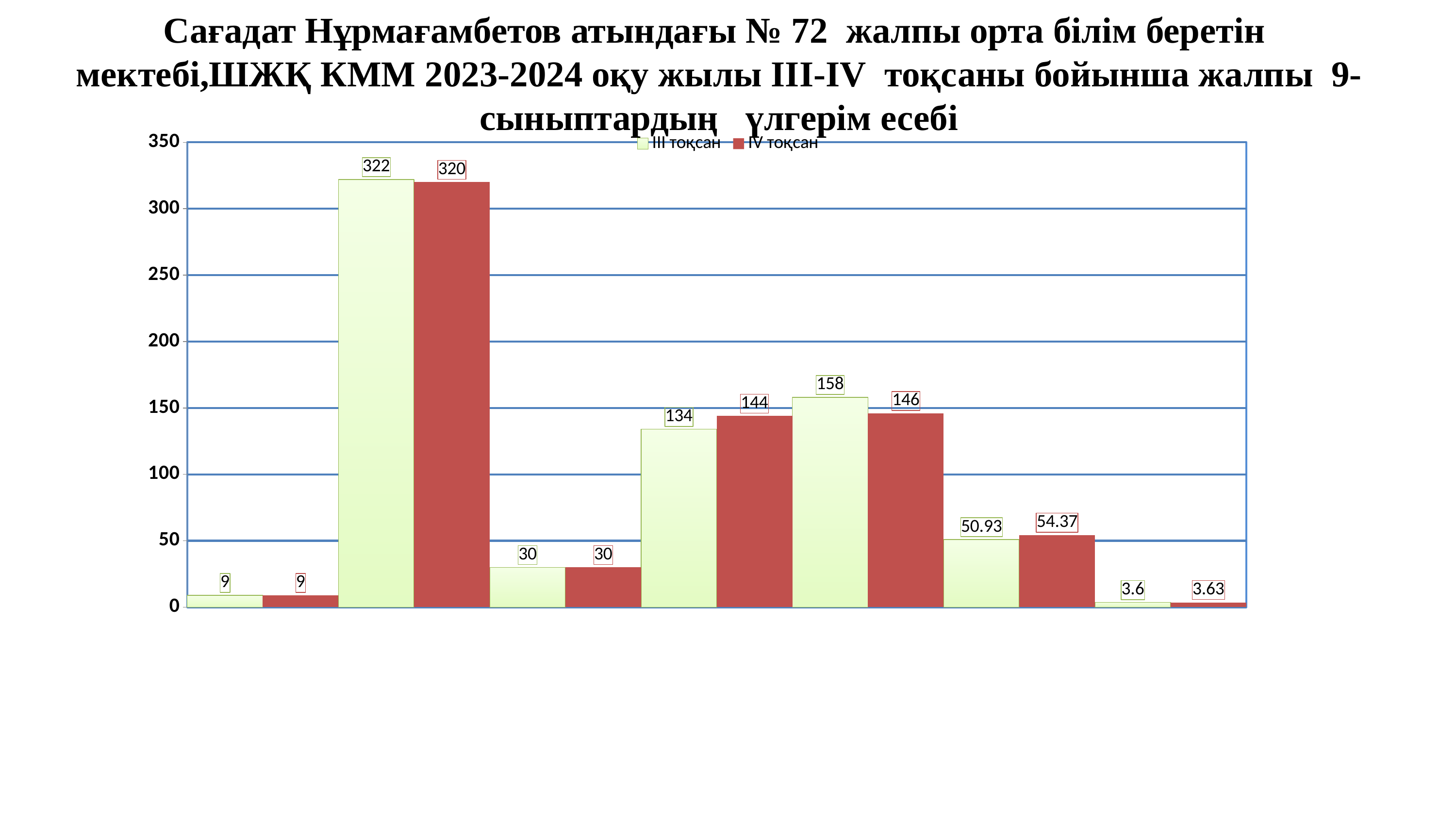
What is the value of the III тоқсан bar in the sixth group of bars from the left? 50.93 What kind of chart is shown on the slide? bar chart What is the value of the IV тоқсан bar in the rightmost group of bars? 3.63 What is the value of the IV тоқсан bar in the second group of bars from the left? 320 How many series does the chart legend list? 2 What is the value of the III тоқсан bar in the second group of bars from the left? 322 Which group of bars has the highest values in the chart? the second group from the left What is the difference between the III тоқсан and IV тоқсан values in the fifth group of bars from the left (158 and 146)? 12 Which series is shown in red in the chart legend? IV тоқсан How many groups of bars are plotted in the chart? 7 In the fourth group of bars from the left, which series has the larger value, III тоқсан or IV тоқсан? IV тоқсан What is the value of the IV тоқсан bar in the fourth group of bars from the left? 144